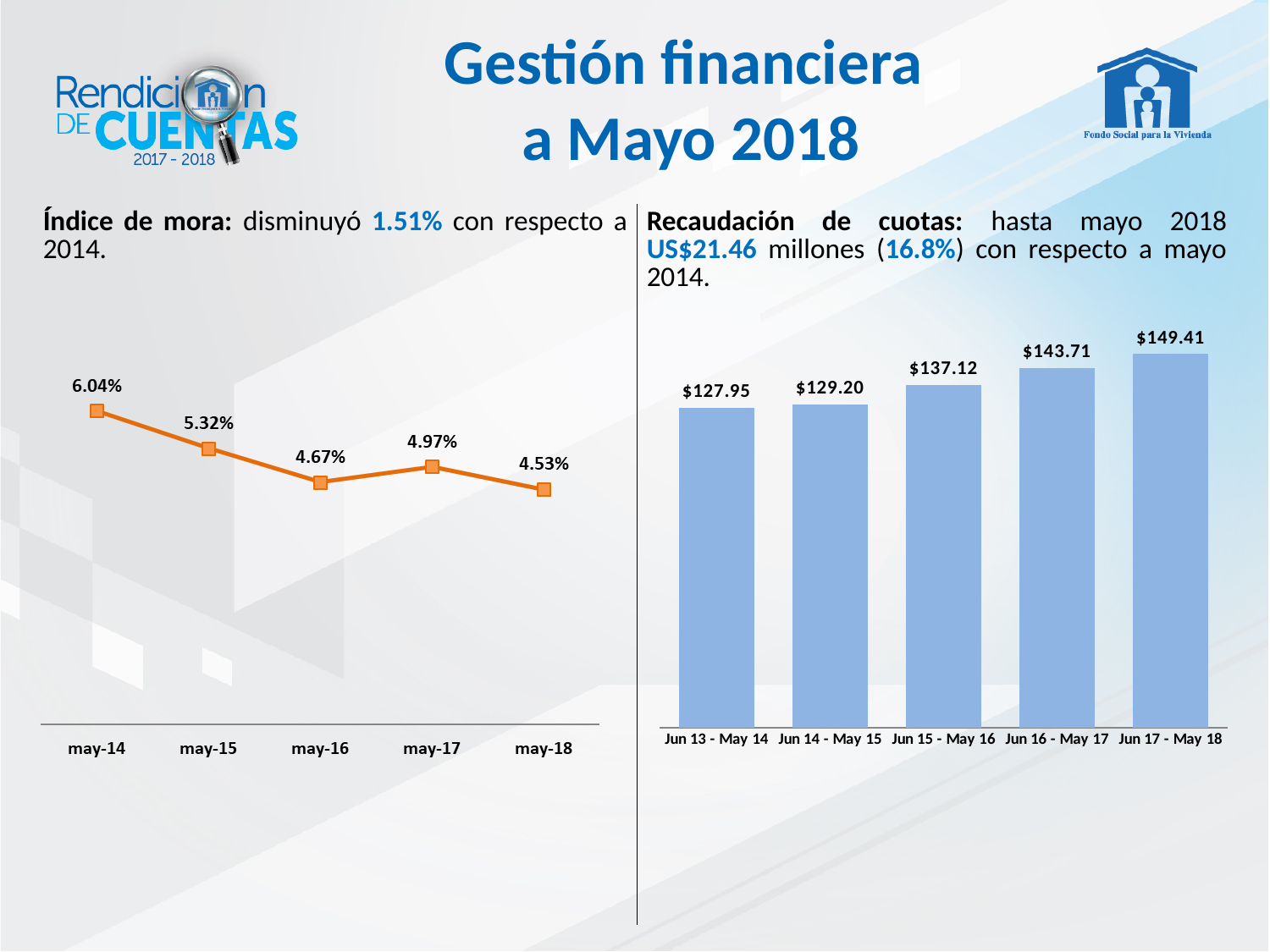
In the right chart (Recaudación de cuotas), do the values rise or fall from left to right? rise In the left chart (Índice de mora), which point has the lowest value? may-18 In the right chart (Recaudación de cuotas), which category has the highest value? Jun 17 - May 18 In the right chart (Recaudación de cuotas), which category has the lowest value? Jun 13 - May 14 In the left chart (Índice de mora), what is the value for may-17? 4.97% In the left chart (Índice de mora), what is the difference between the may-14 and may-18 values? 1.51% In the left chart (Índice de mora), what is the value for may-14? 6.04% In the right chart (Recaudación de cuotas), what is the value for Jun 15 - May 16? $137.12 What kind of chart is the right chart (Recaudación de cuotas)? bar chart In the left chart (Índice de mora), how many data points are plotted? 5 What kind of chart is the left chart (Índice de mora)? line chart In the right chart (Recaudación de cuotas), what is the difference between Jun 17 - May 18 and Jun 13 - May 14? $21.46